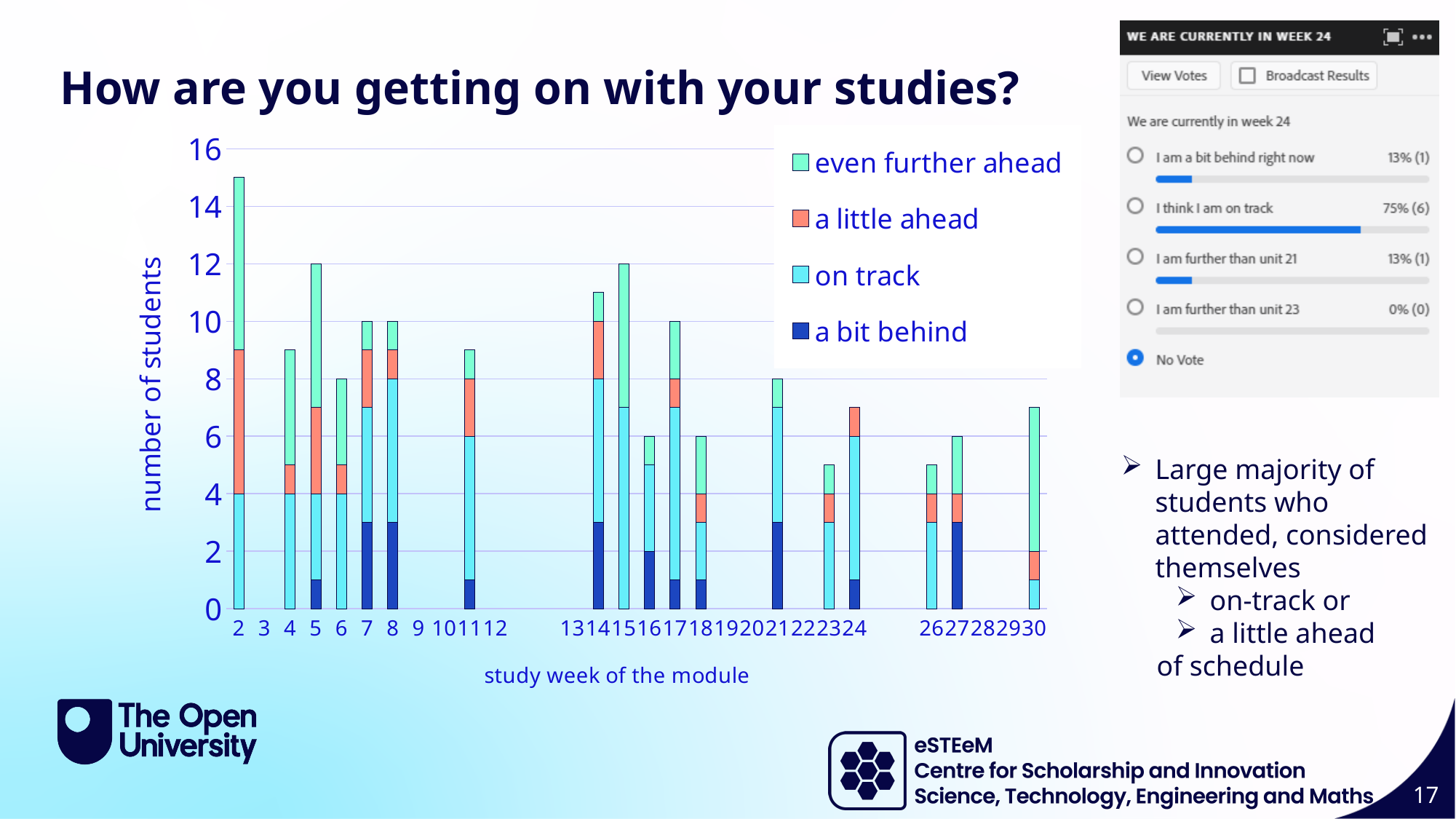
What is the total number of students for study week 15? 12 Which study week has the tallest bar in the chart? 2 Is the total for study week 11 greater or less than 10? less What is the total number of students for study week 8? 10 What is the title of the vertical axis of the bar chart? number of students Which bar is taller, study week 5 or study week 6? study week 5 In the poll screenshot on the right, what percentage of votes was for "I think I am on track"? 75% Is the total for study week 2 greater or less than 14? greater What kind of chart is shown on the left of the slide? stacked bar chart Is the total for study week 14 greater or less than 10? greater How many series does the legend of the bar chart list? 4 What is the total number of students for study week 5? 12